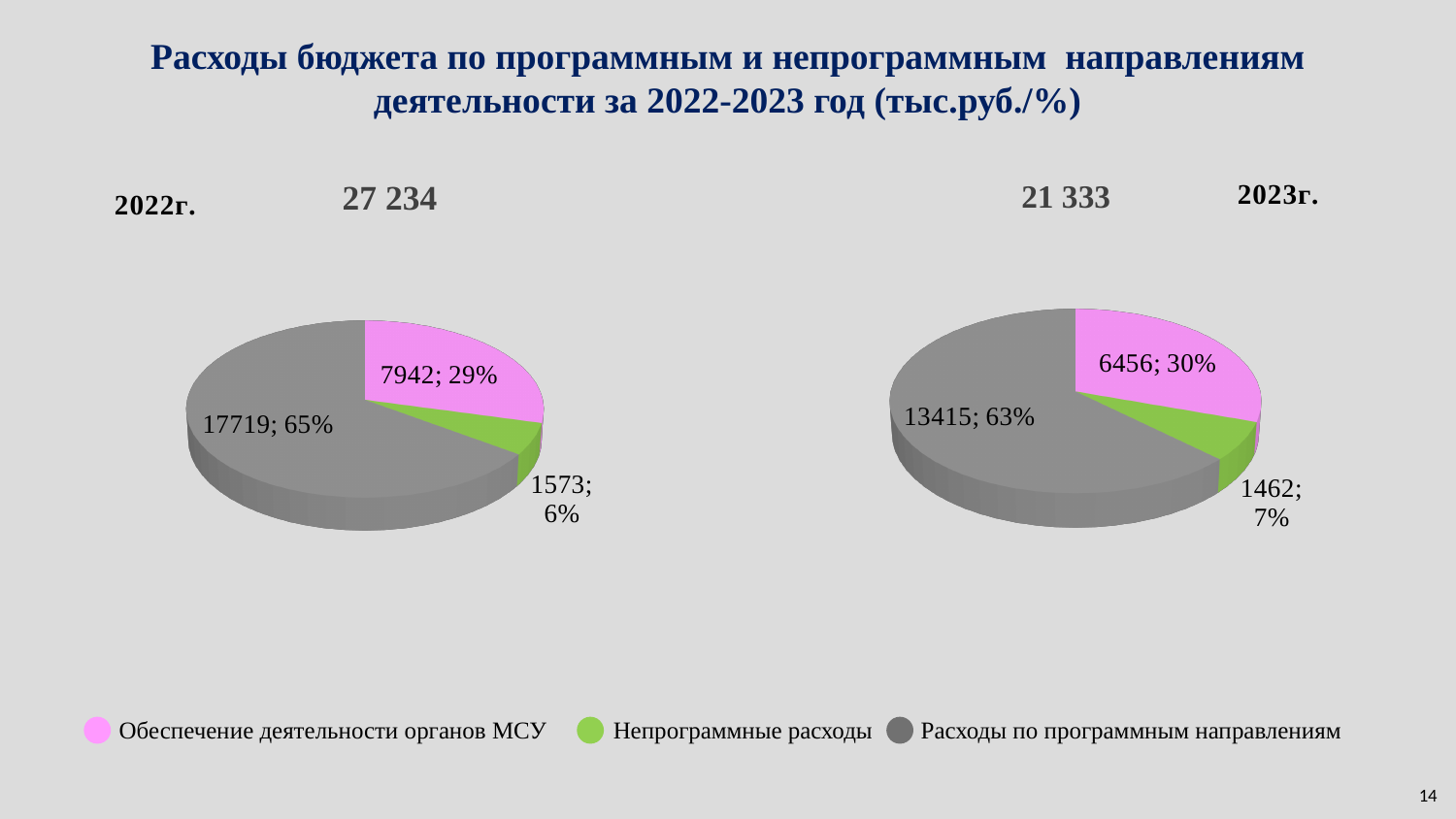
In the 2023 pie chart, what share of the pie is Расходы по программным направлениям? 63% What colour represents Непрограммные расходы in the legend? Green In the 2022 pie chart, what share of the pie is Непрограммные расходы? 6% What is the difference between the value for Обеспечение деятельности органов МСУ in the 2022 chart and in the 2023 chart? 1486 In the 2022 pie chart, what is the value for Расходы по программным направлениям? 17719 Which is larger: Непрограммные расходы in the 2022 chart or in the 2023 chart? 2022 (1573) How many slices does the 2023 pie chart have? 3 How many entries does the legend list? 3 In the 2023 pie chart, which category has the smallest value? Непрограммные расходы In the 2023 pie chart, what is the value for Обеспечение деятельности органов МСУ? 6456 What type of chart is used on this slide? Pie chart In the 2022 pie chart, which category has the largest value? Расходы по программным направлениям